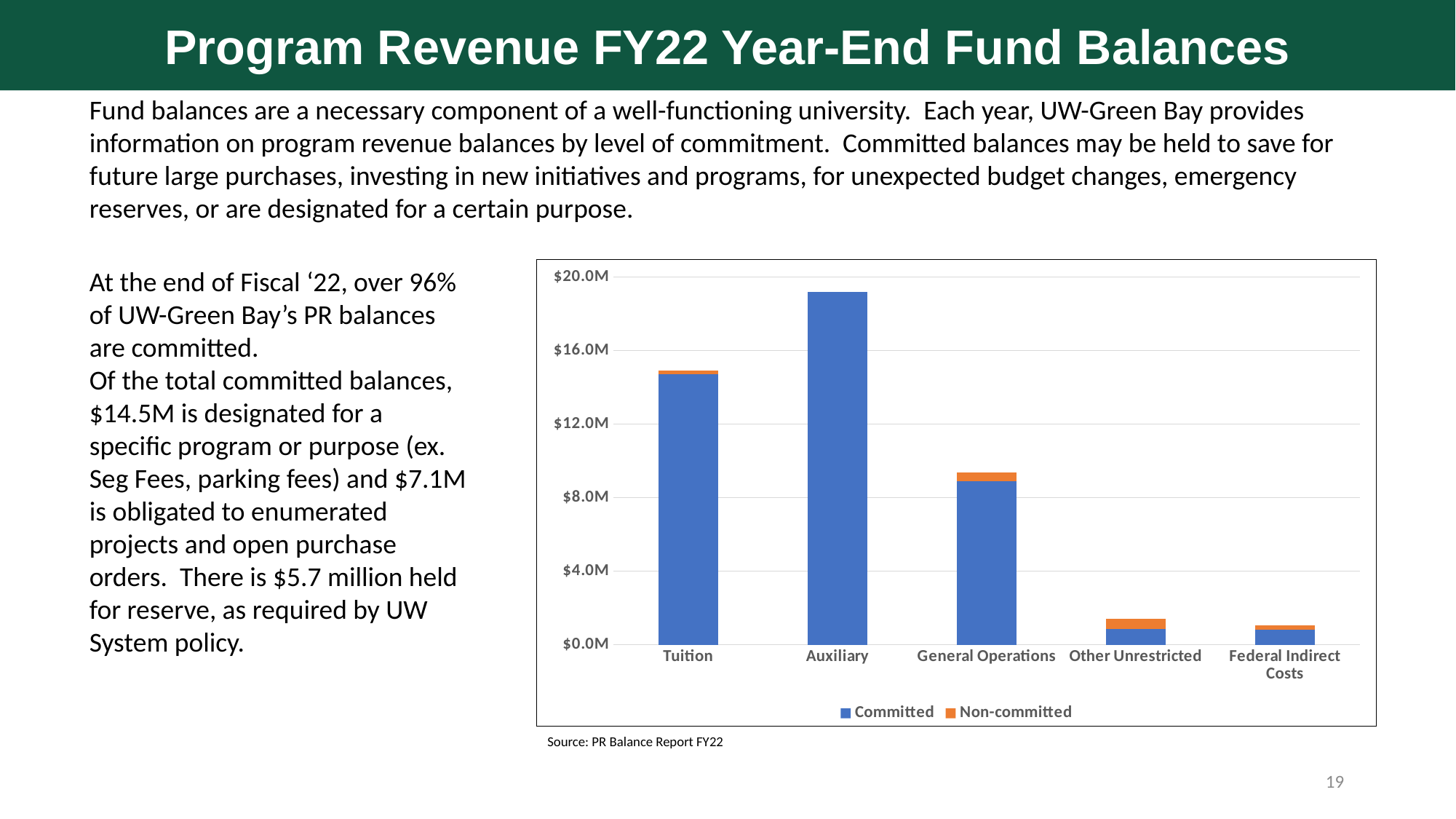
Which category has the lowest total fund balance? Federal Indirect Costs Which has a larger total balance, Tuition or General Operations? Tuition Is the total value for General Operations greater or less than $8.0M? greater How many series does the chart's legend list? 2 Which category has the highest total fund balance? Auxiliary Is the total value for Auxiliary greater or less than $16.0M? greater What source is cited below the chart? PR Balance Report FY22 Is the total value for Other Unrestricted greater or less than $4.0M? less How many categories are shown on the x axis of the chart? 5 What kind of chart is shown on the slide? Stacked bar chart Which series is shown in orange in the chart? Non-committed